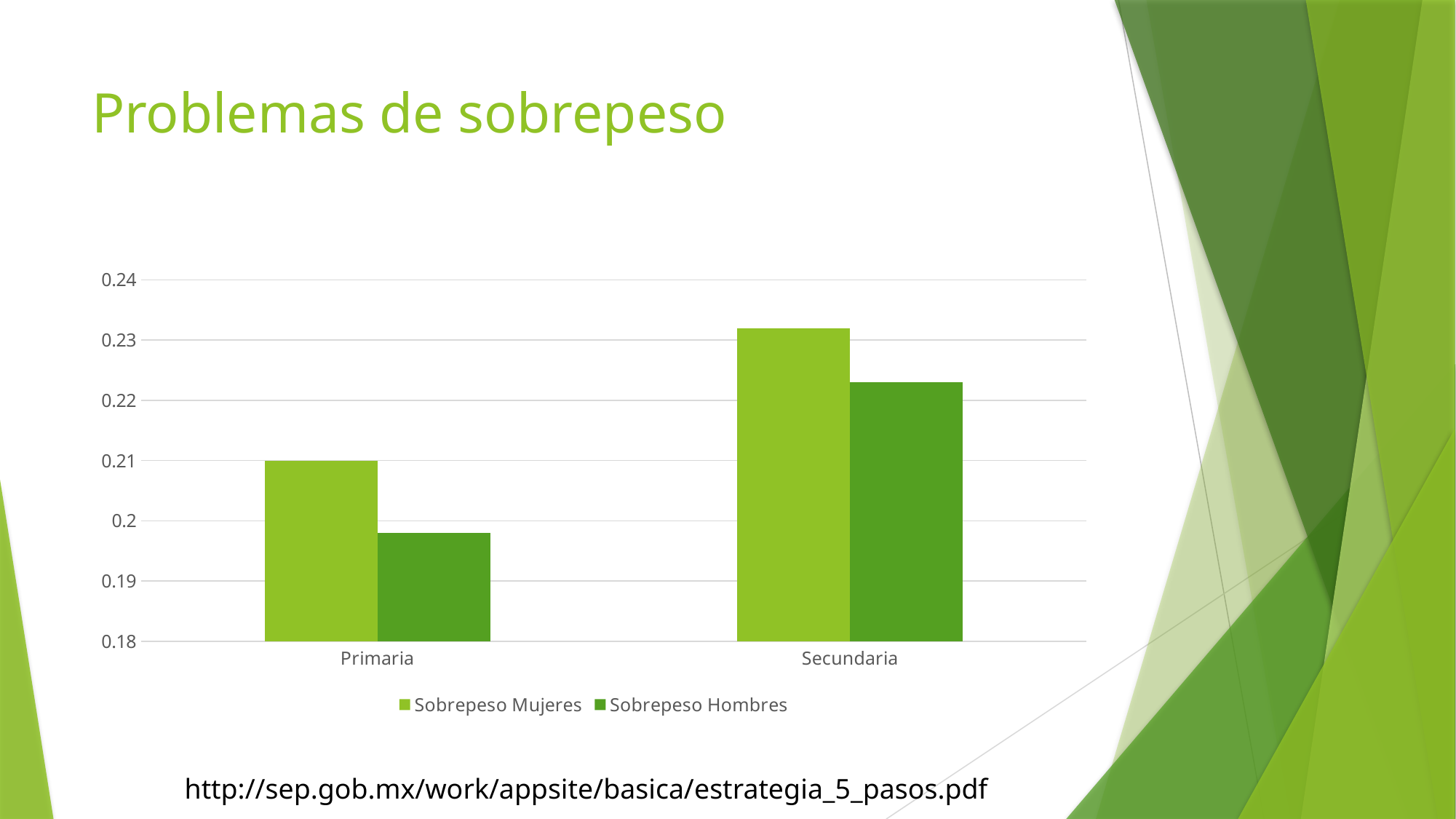
What is the title of the slide containing the chart? Problemas de sobrepeso Which bar is the lowest in the chart? Sobrepeso Hombres for Primaria Is the value for Sobrepeso Mujeres in Secundaria greater or less than 0.23? greater What kind of chart is shown on the slide? bar chart Which category has the higher value for Sobrepeso Mujeres? Secundaria What is the value of Sobrepeso Mujeres for Primaria? 0.21 How many categories are shown on the x axis? 2 What are the two series named in the legend? Sobrepeso Mujeres and Sobrepeso Hombres Do the Sobrepeso Hombres values rise or fall from Primaria to Secundaria? rise For Primaria, which is larger: Sobrepeso Mujeres or Sobrepeso Hombres? Sobrepeso Mujeres Is the value for Sobrepeso Hombres in Primaria greater or less than 0.2? less How many series does the legend list? 2